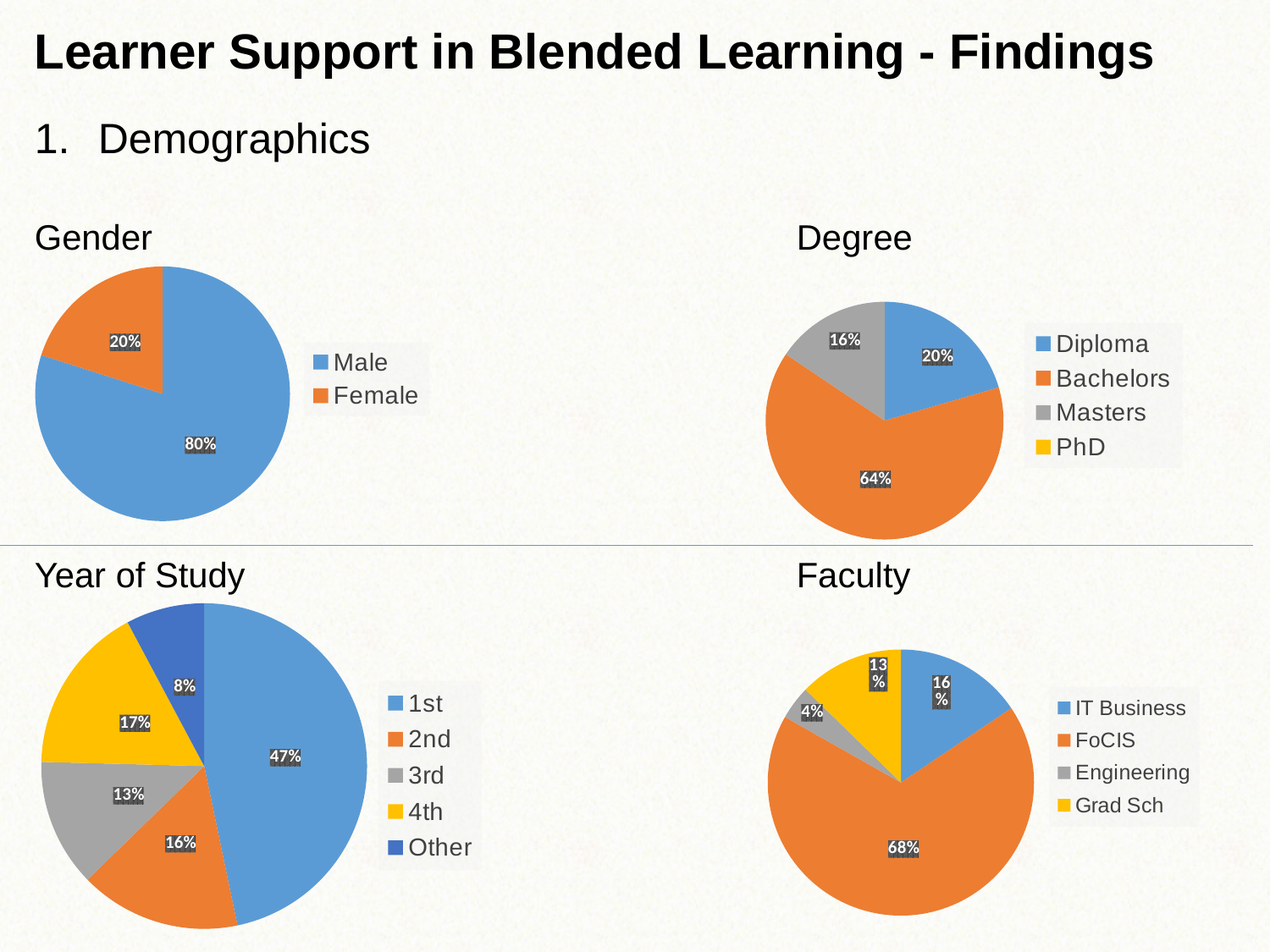
In the Year of Study chart, which is larger, 4th or 2nd? 4th How many categories does the legend of the Year of Study chart list? 5 In the Year of Study chart, which category has the largest share? 1st In the Faculty chart, which category has the smallest share? Engineering In the Gender chart, what is the difference between the Male and Female percentages? 60% In the Gender chart, what percentage is Male? 80% In the Degree chart, what is the difference between the Bachelors and Diploma percentages? 44% What type of chart is the Gender chart? Pie chart In the Year of Study chart, what percentage is 3rd year? 13% In the Faculty chart, what percentage is Engineering? 4% In the Faculty chart, which colour represents FoCIS? Orange In the Degree chart, what percentage is Bachelors? 64%